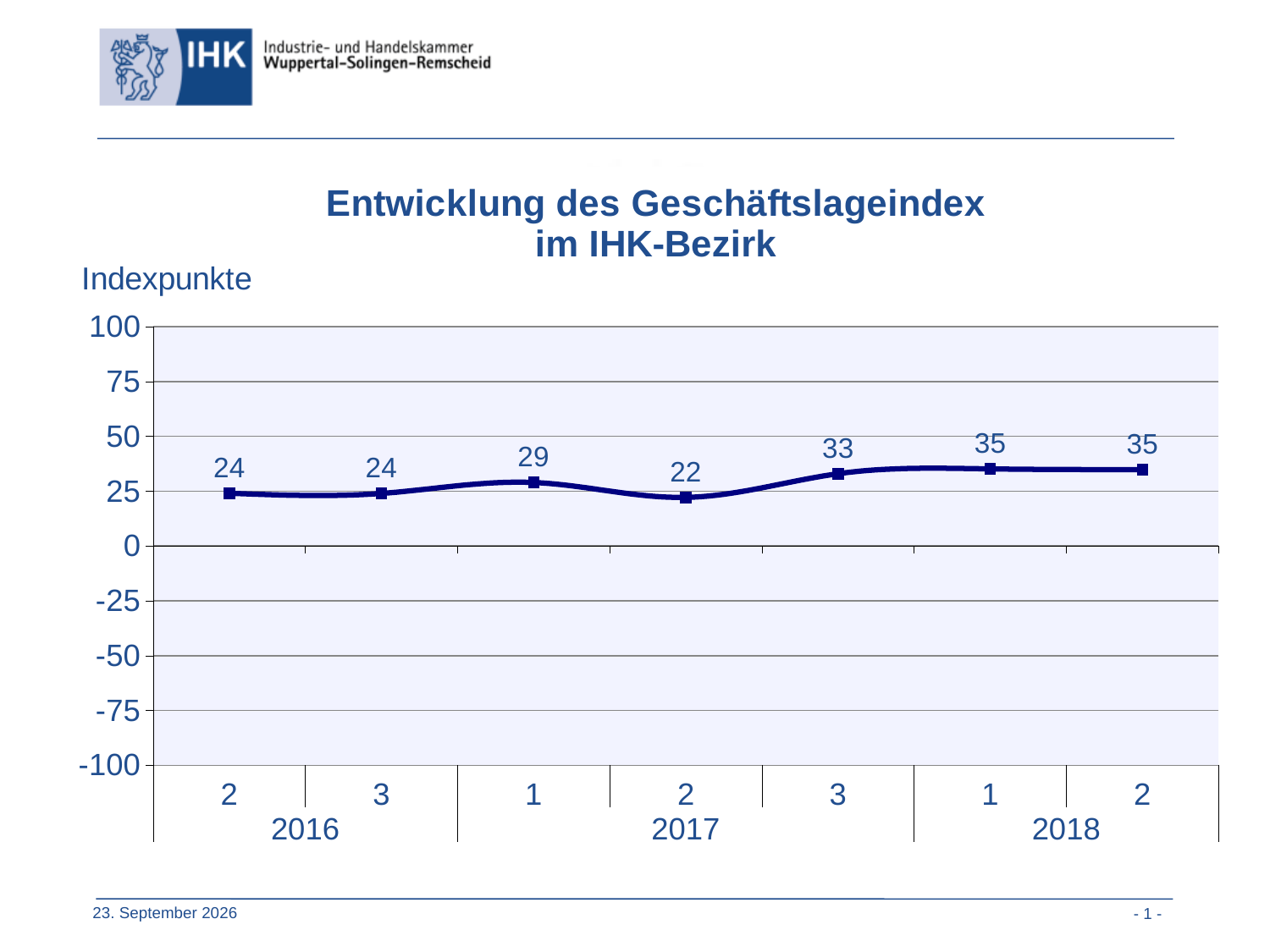
What kind of chart is shown on the slide? line chart Which is larger, the value for period 1 of 2017 or period 2 of 2017? 1 2017 What is the value of the Geschäftslageindex for period 2 of 2018? 35 How many data points are plotted on the chart? 7 What is the difference between the value for period 1 of 2018 and period 2 of 2016? 11 What is the title of the chart? Entwicklung des Geschäftslageindex im IHK-Bezirk What is the value of the Geschäftslageindex for period 3 of 2017? 33 What is the value of the Geschäftslageindex for period 2 of 2017? 22 What is the value of the Geschäftslageindex for period 2 of 2016? 24 Which period has the lowest value on the chart? 2 2017 What is the difference between the value for period 3 of 2017 and period 2 of 2017? 11 What is the value of the Geschäftslageindex for period 1 of 2017? 29